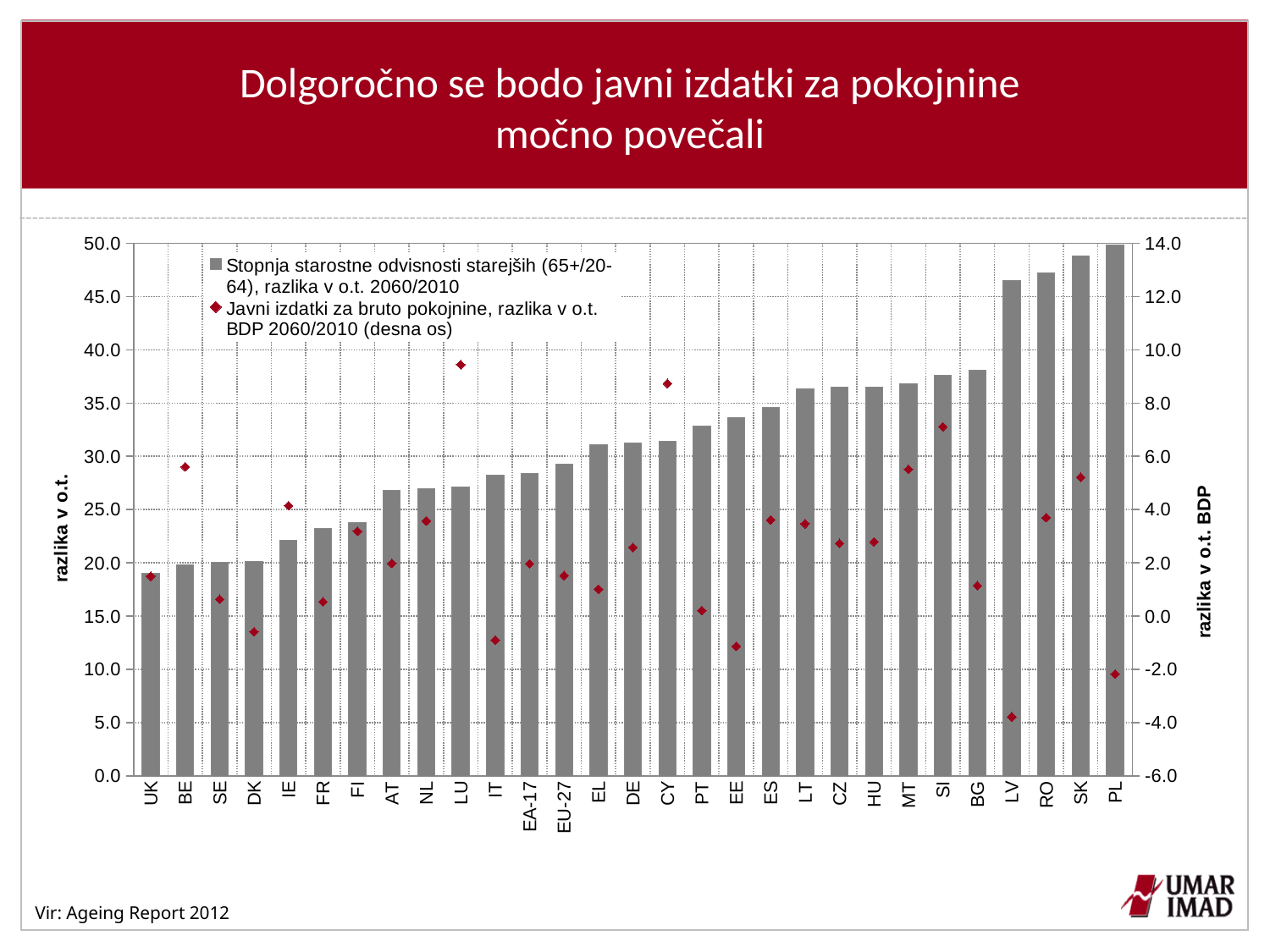
Is the right-axis marker value for EE greater or less than 0.0? less Is the bar value for BE greater or less than 25.0? less Which category has the shortest bar for the old-age dependency ratio difference? UK How many series does the legend list? 2 Is the bar value for LV greater or less than 45.0? greater Which category has the tallest bar for the old-age dependency ratio difference (Stopnja starostne odvisnosti starejših)? PL How many countries or regions are shown on the x axis? 29 Do the bar values rise or fall moving from left to right along the x axis? rise Which category has the highest marker for public pension expenditure difference (Javni izdatki za bruto pokojnine, right axis)? LU Which category has the lowest marker for public pension expenditure difference (right axis)? LV Which has the larger right-axis marker value, BE or SE? BE